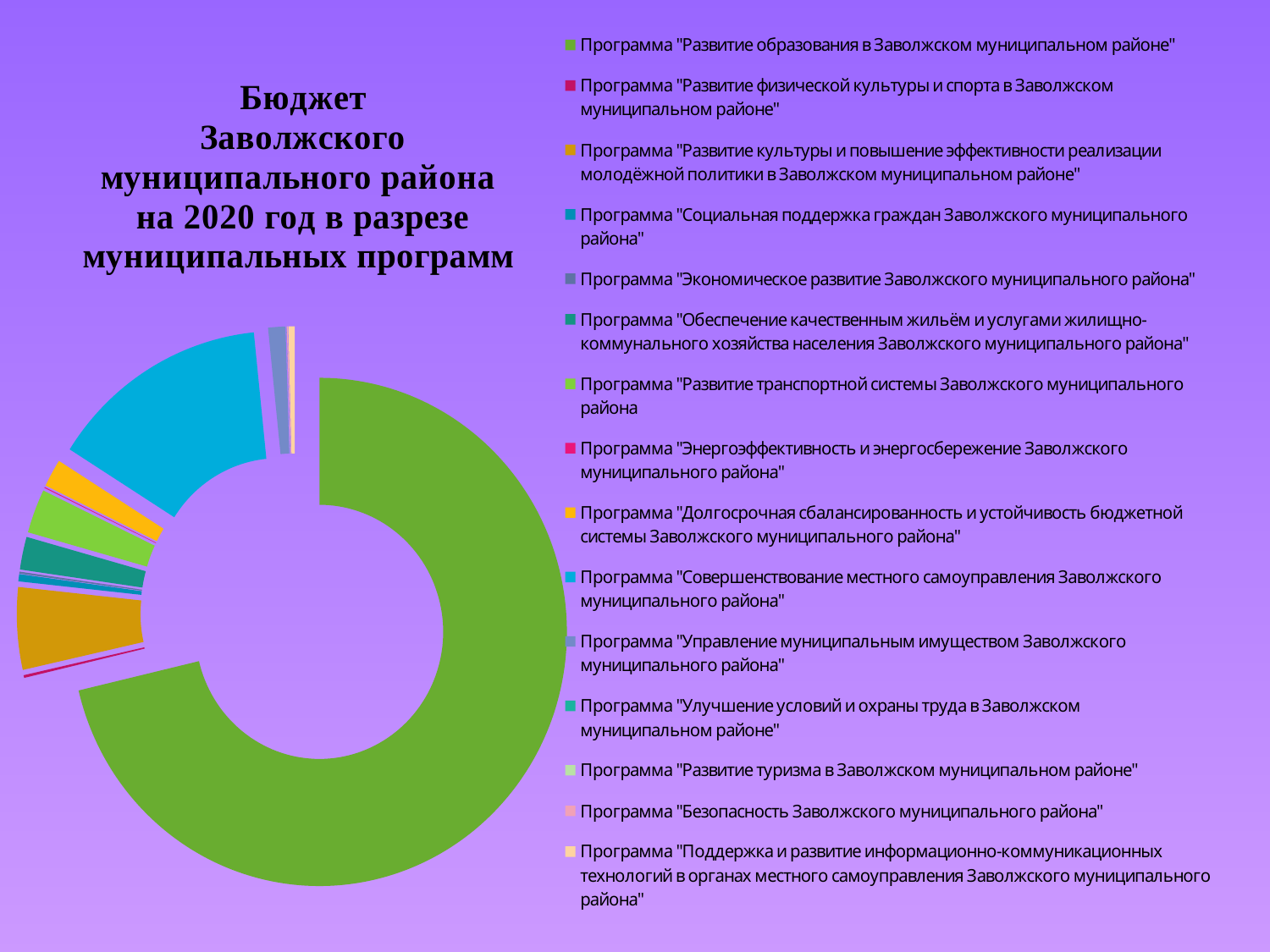
What kind of chart is shown on the slide? Doughnut (pie) chart Which slice is larger: the education program or the social support program? Программа "Развитие образования в Заволжском муниципальном районе" Which slice is larger: the social support program or the tourism program? Программа "Социальная поддержка граждан Заволжского муниципального района" Which program has the largest share of the budget in the chart? Программа "Развитие образования в Заволжском муниципальном районе" Does the education program account for more or less than half of the doughnut? More Which program has the second-largest slice in the chart? Программа "Совершенствование местного самоуправления Заволжского муниципального района" What is the title of the chart on the slide? Бюджет Заволжского муниципального района на 2020 год в разрезе муниципальных программ How many programs does the chart's legend list? 15 What colour is the largest slice of the chart? Green For which year does the chart show the budget? 2020